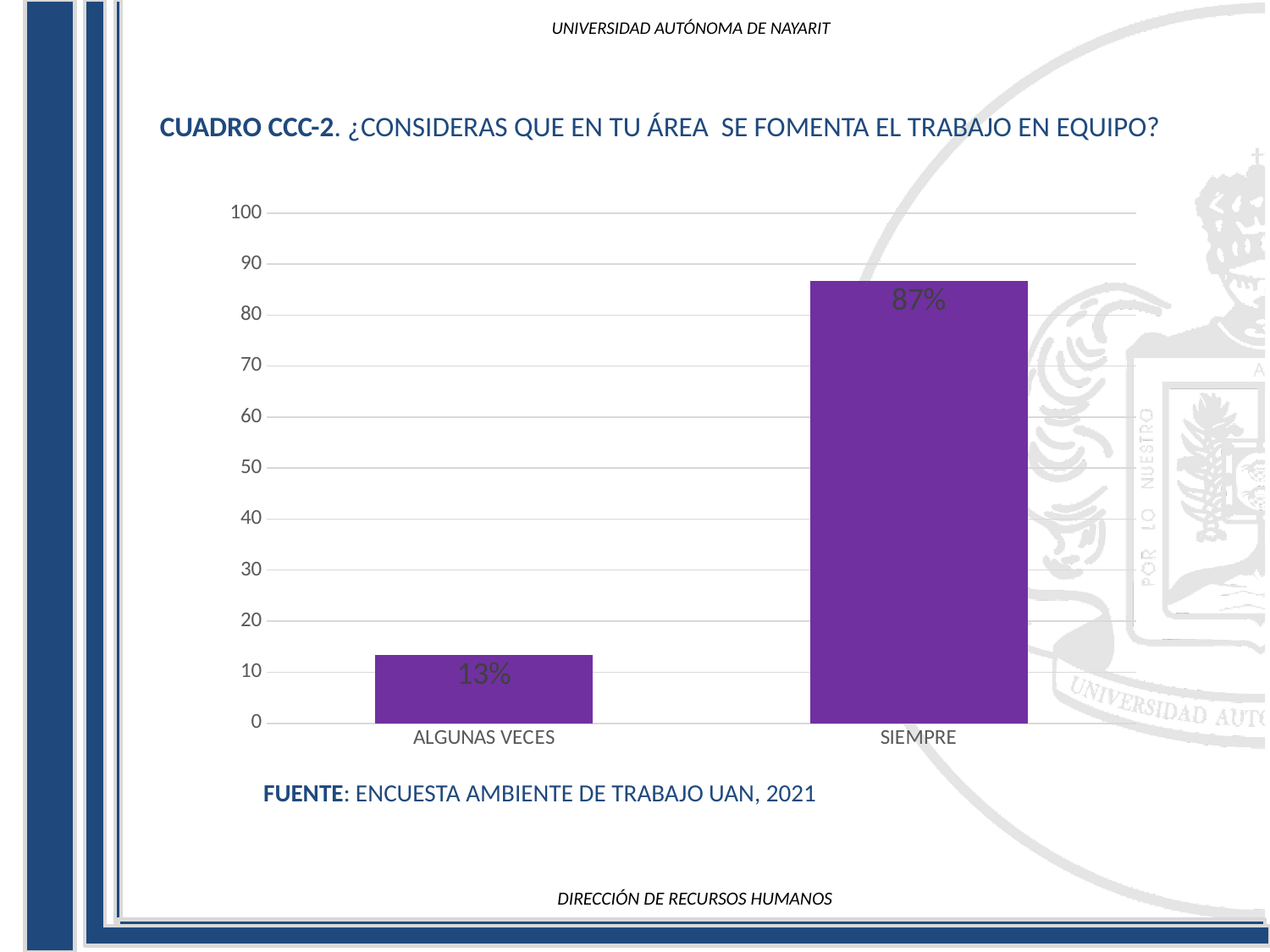
What is the value for ALGUNAS VECES? 13% Which category has the lowest value? ALGUNAS VECES What kind of chart is shown on the slide? bar chart What is the difference between the values for SIEMPRE and ALGUNAS VECES? 74% What is the value for SIEMPRE? 87% Which category has the highest value? SIEMPRE How many categories are shown on the x axis? 2 Which is larger, the value for ALGUNAS VECES or the value for SIEMPRE? SIEMPRE What is the source cited below the chart? ENCUESTA AMBIENTE DE TRABAJO UAN, 2021 Is the value for SIEMPRE greater or less than 80? greater Is the value for ALGUNAS VECES greater or less than 20? less What colour are the bars in the chart? purple